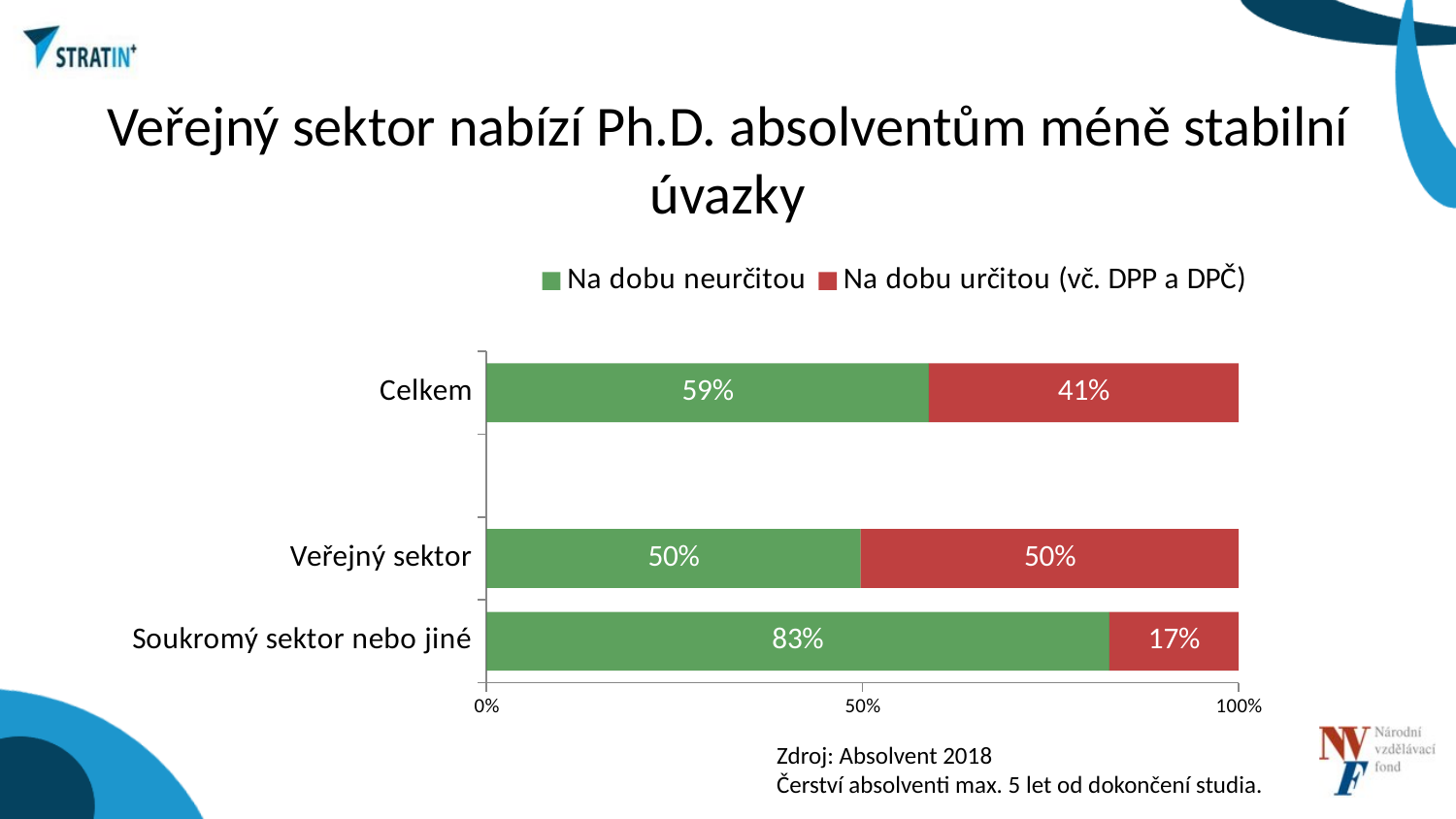
What is the value for 'Na dobu neurčitou' in the 'Soukromý sektor nebo jiné' category? 83% What kind of chart is shown on the slide? Stacked bar chart How many categories are shown on the chart? 3 What is the value for 'Na dobu neurčitou' in the 'Celkem' category? 59% How many series does the legend list? 2 Which category has the highest value for 'Na dobu neurčitou'? Soukromý sektor nebo jiné What is the difference between the 'Na dobu neurčitou' values for 'Soukromý sektor nebo jiné' and 'Veřejný sektor'? 33 percentage points Which is larger: the 'Na dobu určitou (vč. DPP a DPČ)' value for 'Celkem' or for 'Soukromý sektor nebo jiné'? Celkem What colour represents the 'Na dobu neurčitou' series? Green What is the value for 'Na dobu určitou (vč. DPP a DPČ)' in the 'Veřejný sektor' category? 50% What is the value for 'Na dobu určitou (vč. DPP a DPČ)' in the 'Soukromý sektor nebo jiné' category? 17% Which category has the lowest value for 'Na dobu určitou (vč. DPP a DPČ)'? Soukromý sektor nebo jiné